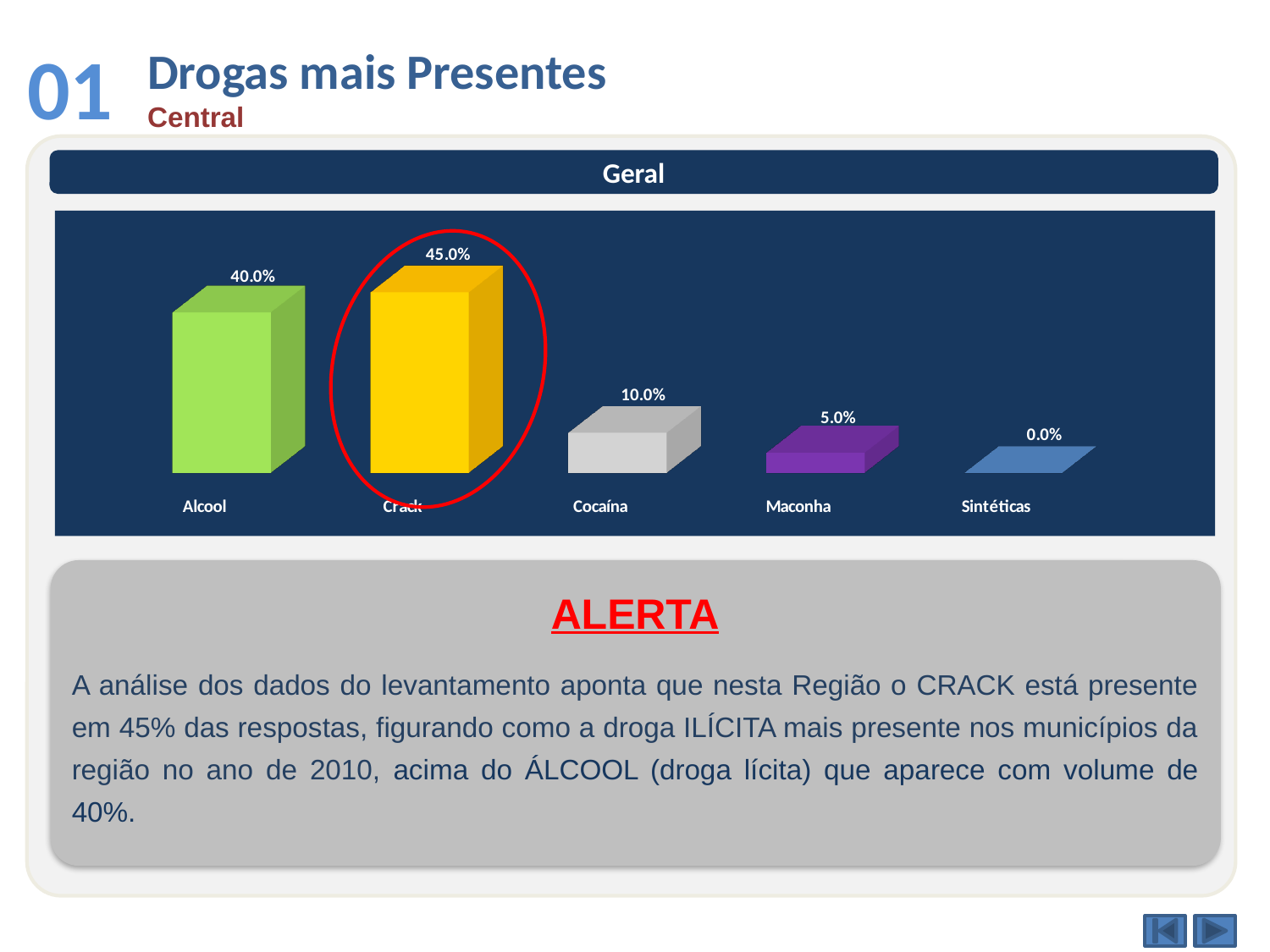
Which category has the lowest value? Sintéticas What is the value for Cocaína? 10.0% What is the title shown above the chart? Geral How many categories are shown in the chart? 5 What is the value for Alcool? 40.0% Which is larger, the value for Cocaína or the value for Maconha? Cocaína What is the value for Maconha? 5.0% What is the difference between the values for Crack and Alcool? 5.0% What is the value for Crack? 45.0% What is the value for Sintéticas? 0.0% Which category has the highest value? Crack What kind of chart is shown on the slide? Bar chart